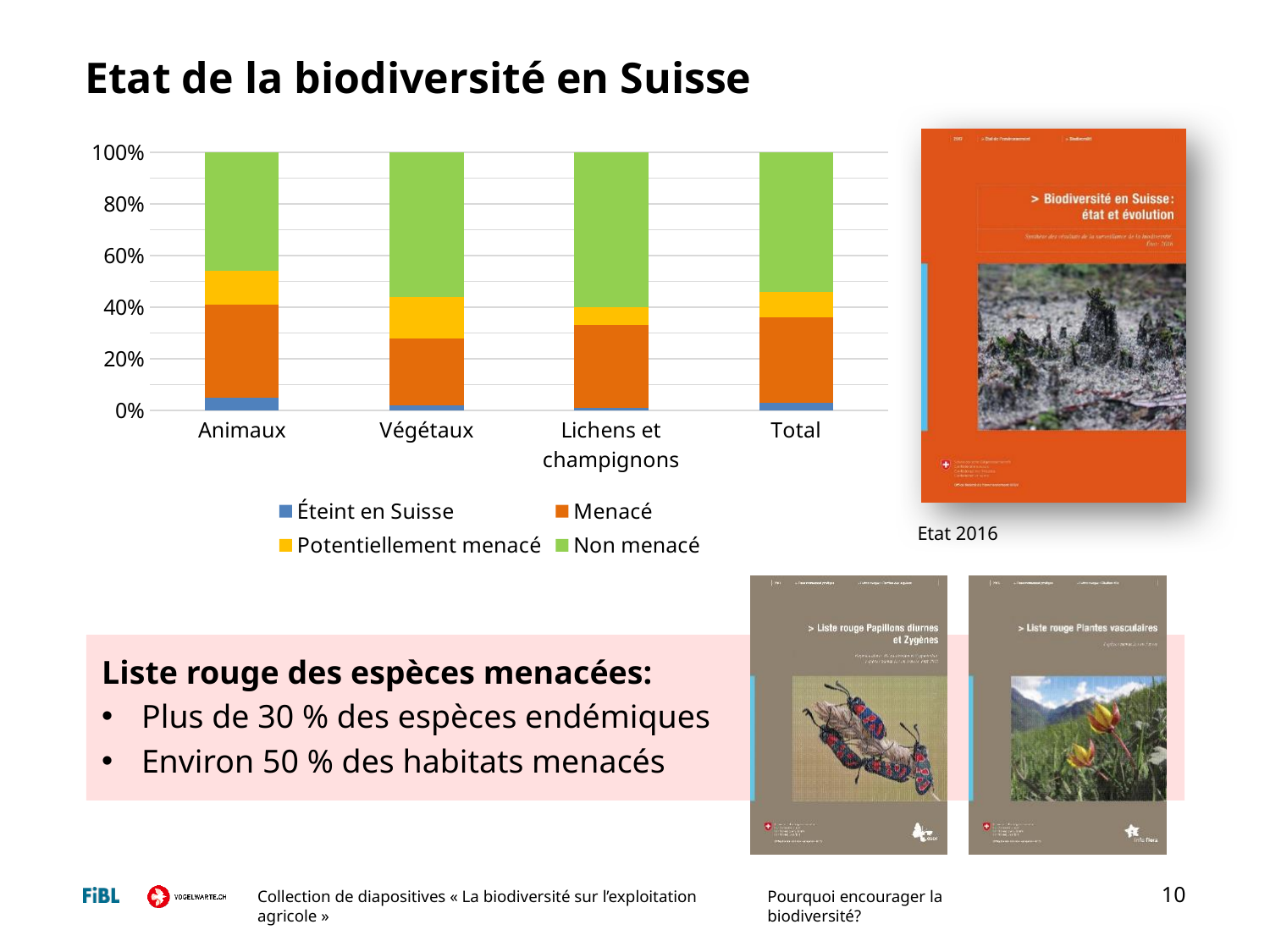
What is the total height of each stacked bar in the chart? 100% Is the 'Non menacé' share for Animaux greater or less than 60%? less Which colour represents the 'Non menacé' series in the chart? Green Is the combined share of 'Éteint en Suisse' and 'Menacé' for Végétaux greater or less than 40%? less Which category has the largest 'Éteint en Suisse' segment? Animaux Is the 'Non menacé' share for Lichens et champignons greater or less than 40%? greater Is the 'Potentiellement menacé' segment larger for Végétaux or for Lichens et champignons? Végétaux Is the 'Menacé' segment larger for Animaux or for Végétaux? Animaux Which category has the smallest 'Non menacé' segment? Animaux What type of chart is shown on the slide? Stacked bar chart How many categories are shown on the x axis of the chart? 4 How many series does the chart legend list? 4